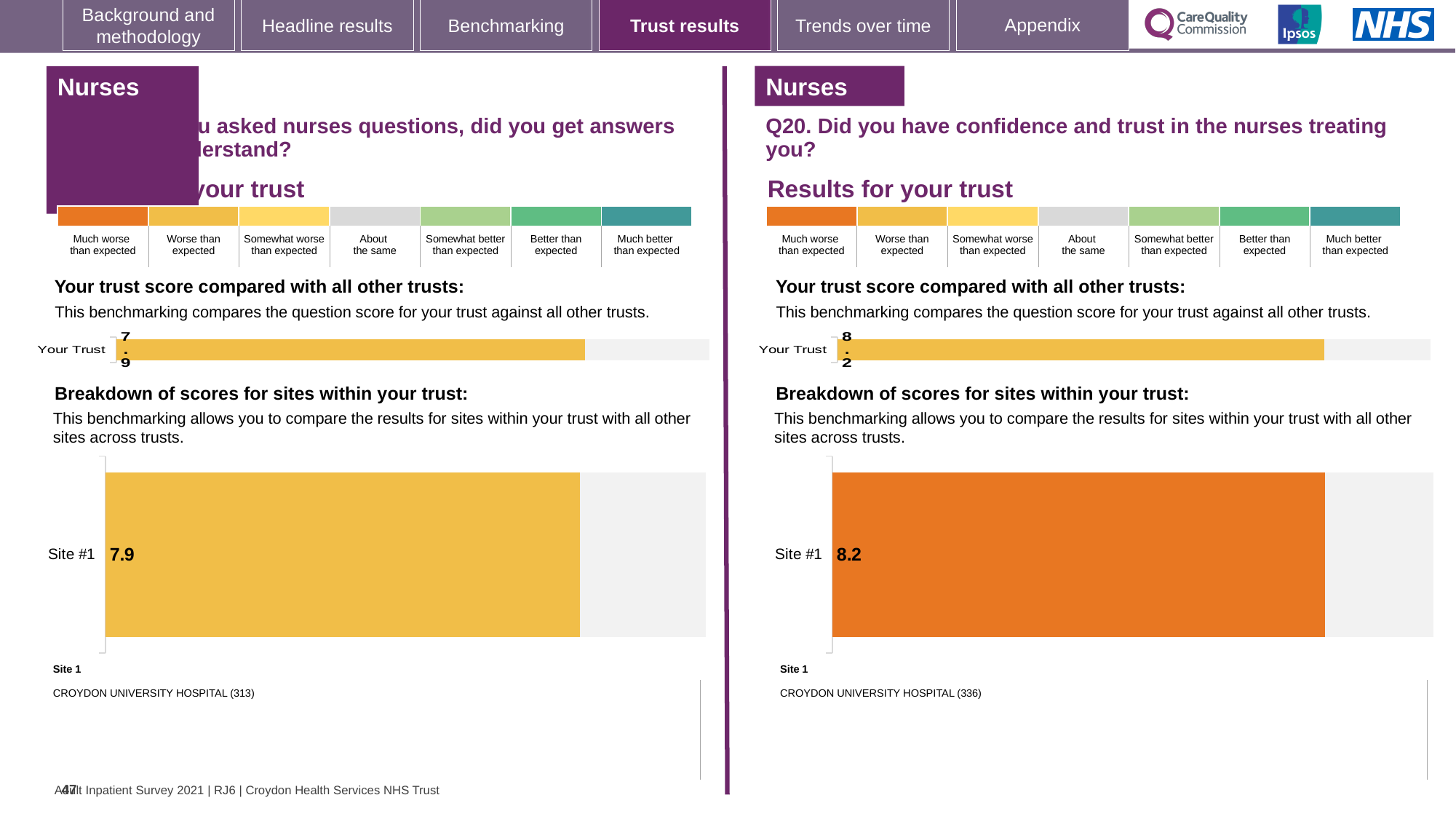
What colour is the Site #1 bar on the right-hand (Q20) breakdown chart? Orange On the left-hand 'Your trust score compared with all other trusts' chart, what is the score for Your Trust? 7.9 On the right-hand (Q20) 'Breakdown of scores for sites within your trust' chart, what is the score for Site #1? 8.2 Which is larger: the Site #1 score on the left-hand breakdown chart or the Site #1 score on the right-hand (Q20) breakdown chart? Right-hand (Q20) Site #1 (8.2) On the left-hand 'Breakdown of scores for sites within your trust' chart, what is the score for Site #1? 7.9 What is the difference between the Your Trust score on the right-hand (Q20) chart and the Your Trust score on the left-hand chart? 0.3 What type of chart is used to show the Site #1 score on the right-hand (Q20) breakdown chart? Bar chart On the right-hand (Q20) 'Your trust score compared with all other trusts' chart, what is the score for Your Trust? 8.2 How many sites are shown on the right-hand (Q20) 'Breakdown of scores for sites within your trust' chart? 1 How many sites are shown on the left-hand 'Breakdown of scores for sites within your trust' chart? 1 What colour is the Site #1 bar on the left-hand breakdown chart? Yellow Which site name is listed as Site 1 below the right-hand (Q20) breakdown chart? CROYDON UNIVERSITY HOSPITAL (336)